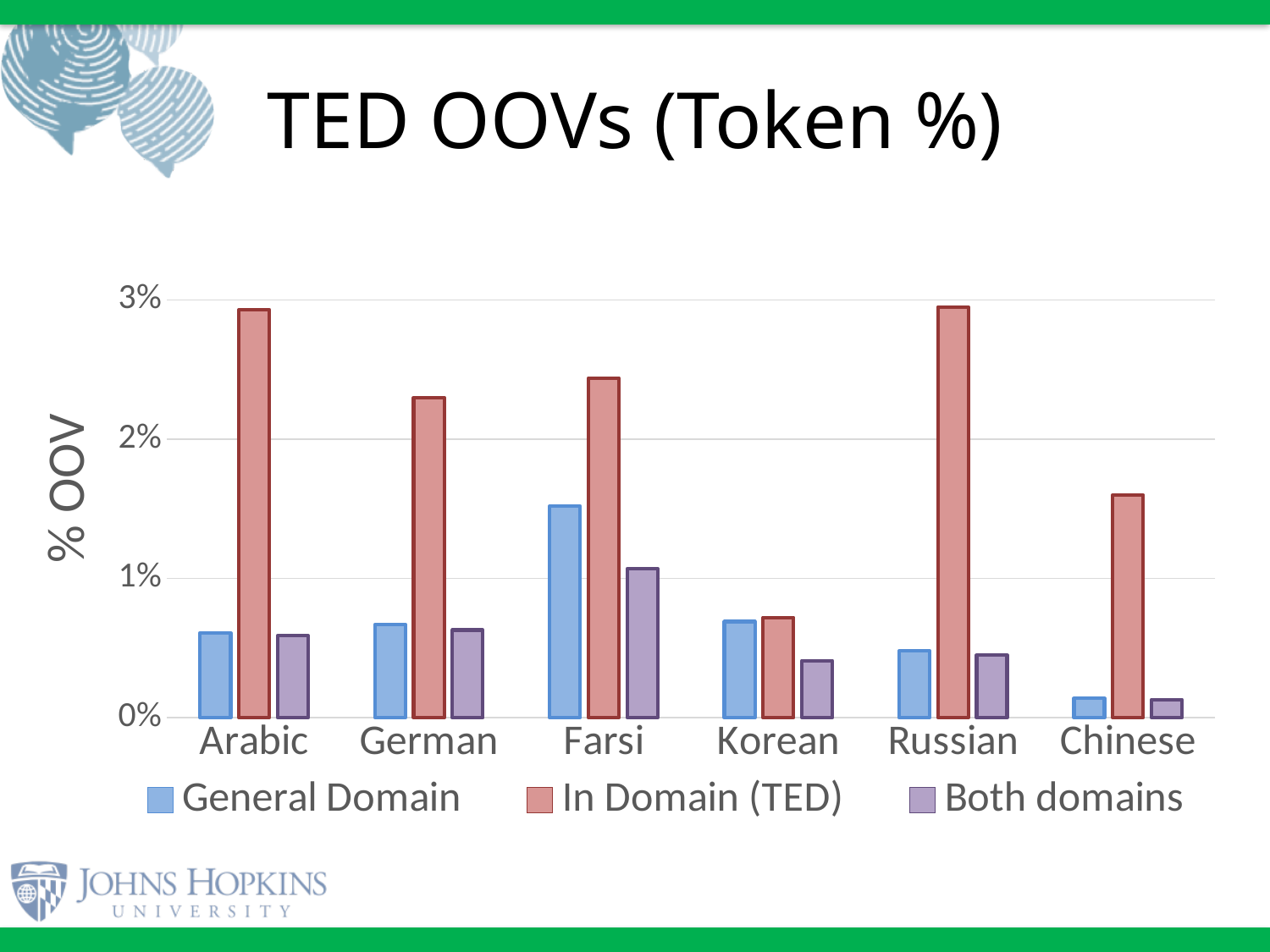
Which language has the lowest In Domain (TED) value? Korean What is the title of the chart? TED OOVs (Token %) Is the In Domain (TED) value for Arabic greater or less than 2%? greater Is the In Domain (TED) value for Chinese greater or less than 2%? less Which language has the highest General Domain value? Farsi Which is larger, the In Domain (TED) value for Farsi or for Chinese? Farsi What is the label on the y axis of the chart? % OOV How many languages are shown on the x axis of the chart? 6 Which language has the lowest General Domain value? Chinese What kind of chart is shown on the slide? bar chart How many series does the chart's legend list? 3 Is the General Domain value for Farsi greater or less than 1%? greater